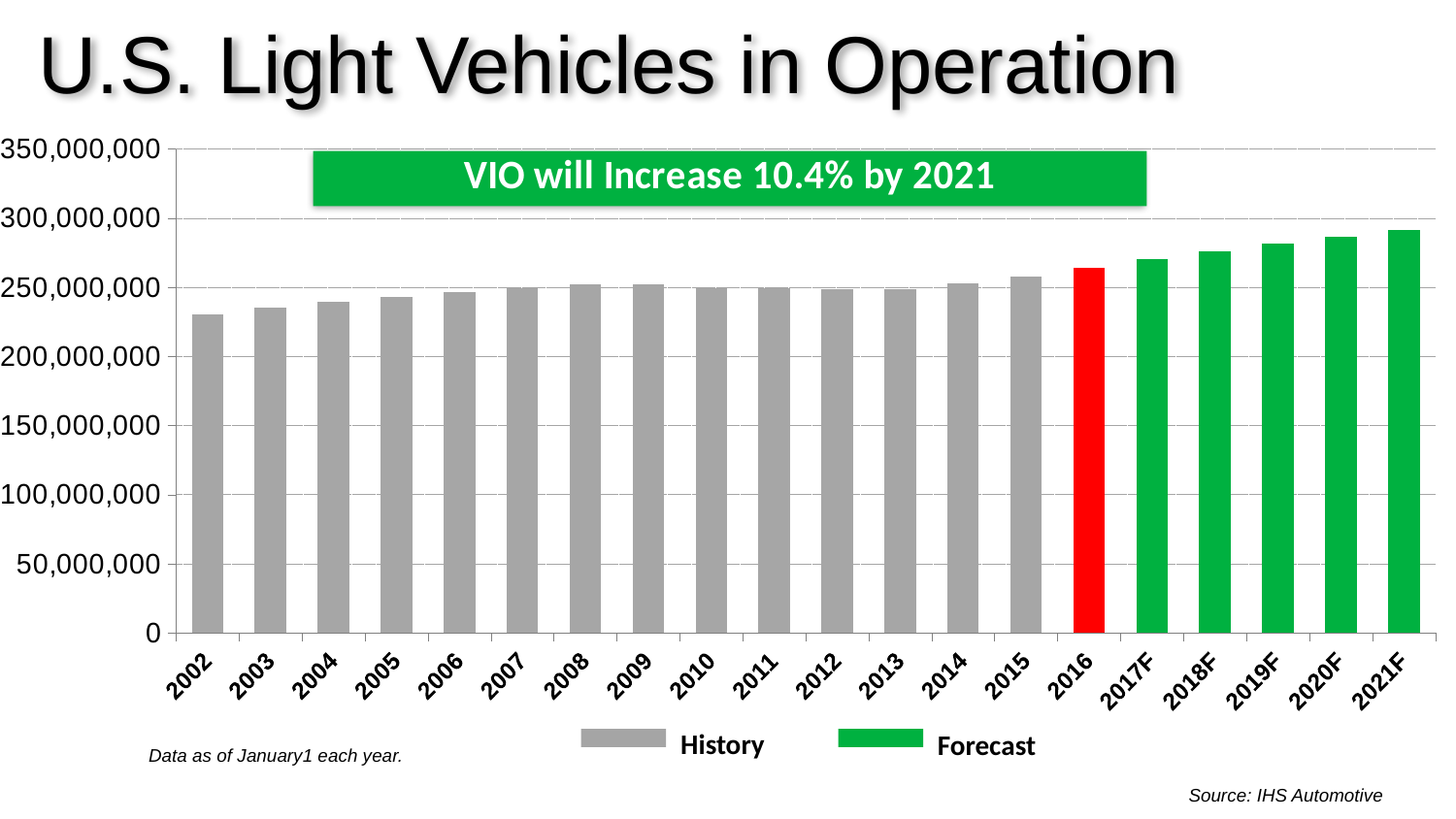
Which year has the lowest value? 2002 Is the value for 2002 greater or less than 250,000,000? less What is the title of the chart? U.S. Light Vehicles in Operation How many years (categories) are shown on the x axis? 20 What kind of chart is shown on the slide? bar chart According to the text box on the chart, by what percentage will VIO increase by 2021? 10.4% How many entries does the legend list? 2 Is the value for 2021F greater or less than 250,000,000? greater Do the values generally rise or fall from 2002 to 2021F? rise Which is larger, the value for 2002 or the value for 2021F? 2021F Is the value for 2016 greater or less than 300,000,000? less Which year has the highest value? 2021F